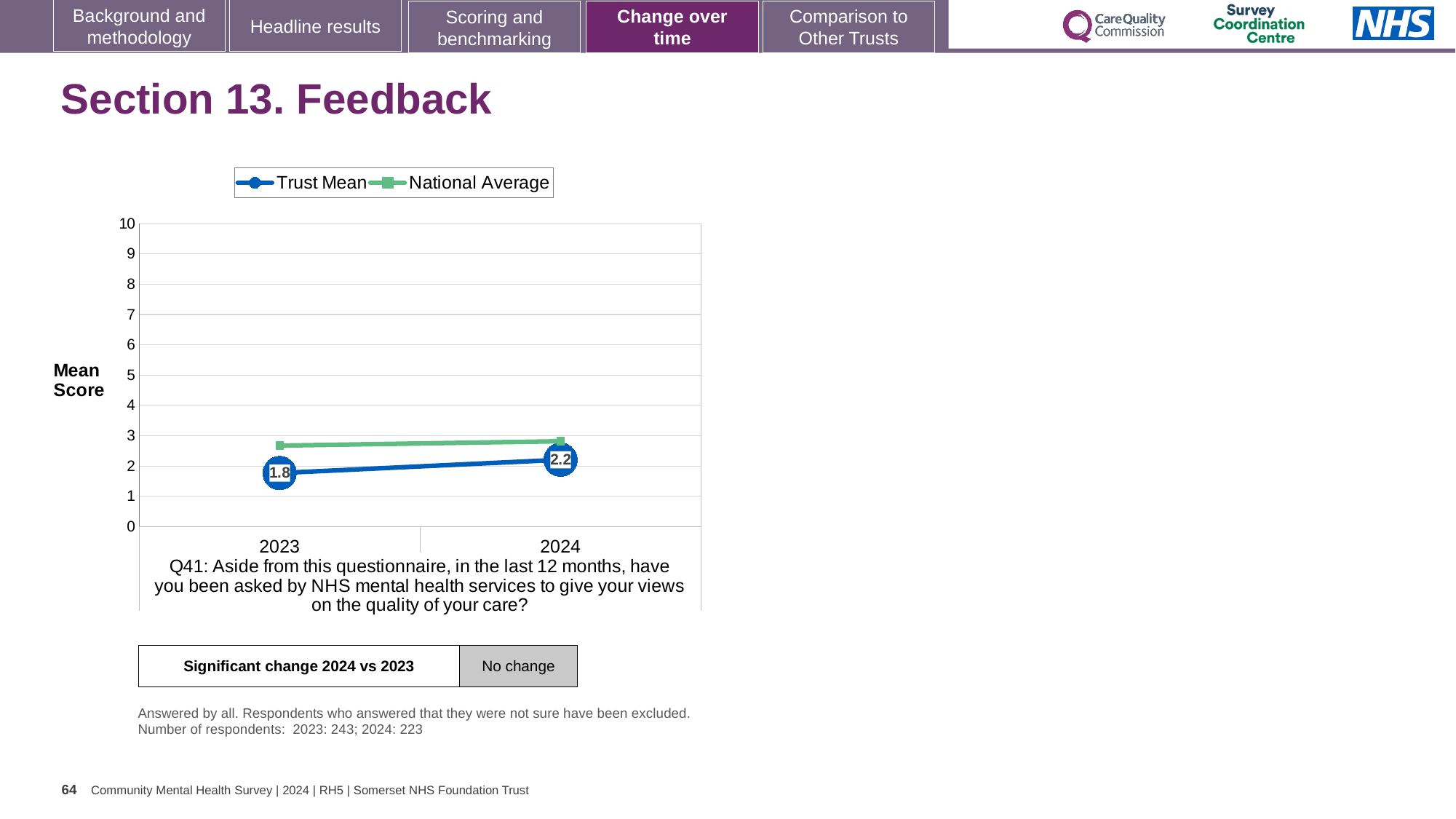
What is the Trust Mean value for 2024? 2.2 In 2024, which is higher, the Trust Mean or the National Average? National Average How many years are plotted on the x axis? 2 What is the Trust Mean value for 2023? 1.8 In which year is the Trust Mean higher, 2023 or 2024? 2024 How many series does the legend list? 2 What kind of chart is shown on the slide? line chart Does the Trust Mean rise or fall from 2023 to 2024? rise What is the difference between the Trust Mean in 2024 and in 2023? 0.4 Is the National Average value for 2023 greater or less than 2? greater Is the National Average value for 2023 greater or less than 3? less In 2023, which is higher, the Trust Mean or the National Average? National Average